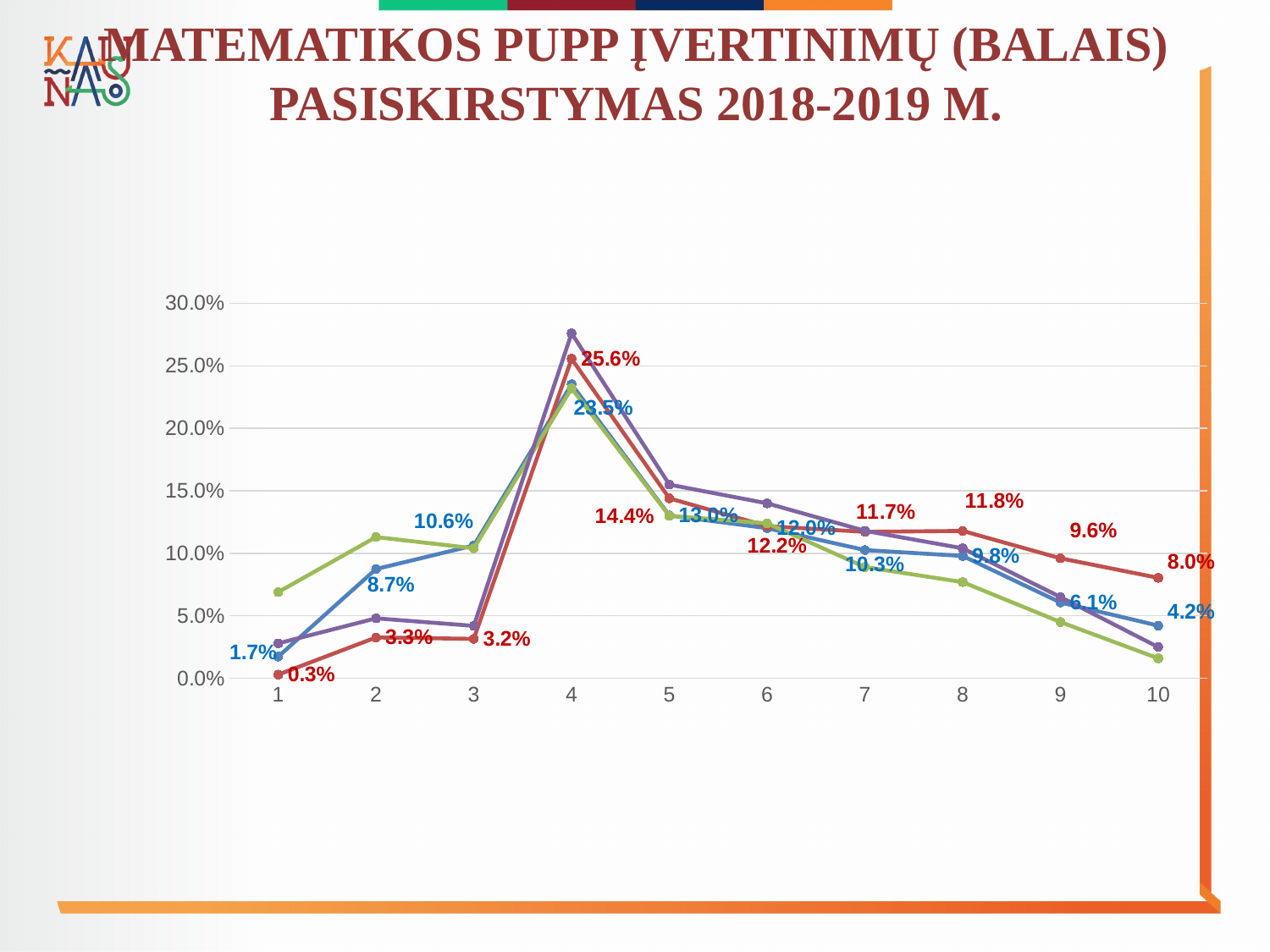
How many score categories are shown on the x axis? 10 At which score does the red line reach its highest value? 4 What is the value of the blue line at score 3? 10.6% What is the difference between the red line's value at score 4 (25.6%) and the blue line's value at score 4 (23.5%)? 2.1% What is the value of the red line at score 10? 8.0% What kind of chart is shown on the slide? line chart Is the value of the green line at score 10 greater or less than 5.0%? less What is the value of the red line at score 4? 25.6% At which score does the blue line have its lowest value? 1 At score 2, which line has the larger value, the blue line (8.7%) or the red line (3.3%)? blue line What is the value of the blue line at score 4? 23.5% Is the value of the purple line at score 4 greater or less than 25.0%? greater